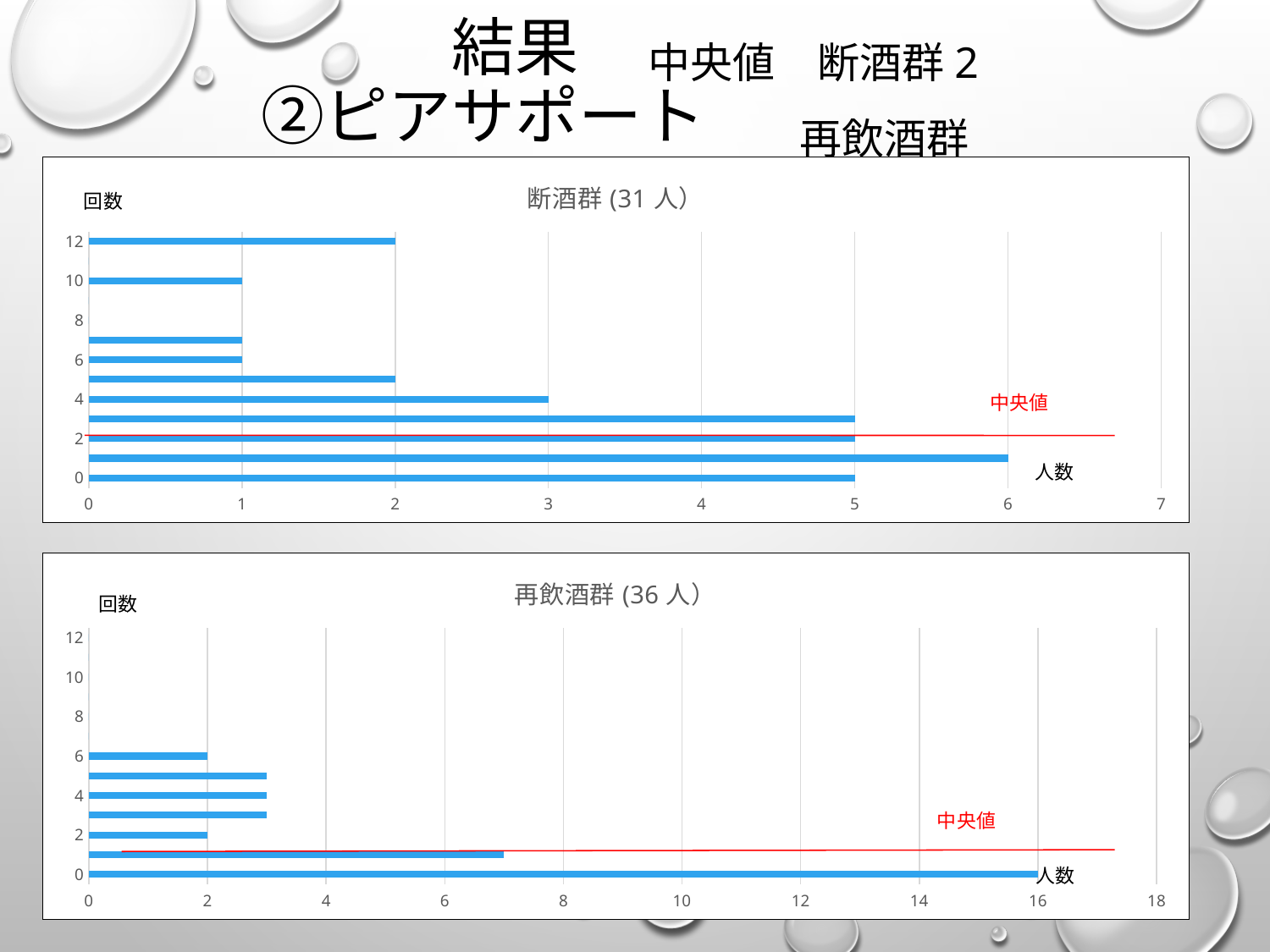
In the bottom chart (再飲酒群), which 回数 category has the highest 人数? 0 In the top chart (断酒群), which has the larger 人数: 回数 4 or 回数 5? 回数 4 In the top chart (断酒群), which 回数 category has the highest 人数? 1 In the top chart (断酒群), what is the difference in 人数 between 回数 0 and 回数 4? 2 How many bars are plotted in the bottom chart (再飲酒群)? 7 What kind of chart is the top chart titled 断酒群 (31 人)? bar chart What does the red horizontal line in each chart represent, according to its label? 中央値 In the bottom chart (再飲酒群), is the 人数 value for 回数 1 greater or less than 6? greater In the bottom chart (再飲酒群), what is the 人数 value for 回数 0? 16 In the top chart (断酒群), what is the 人数 value for 回数 4? 3 In the top chart (断酒群), what is the 人数 value for 回数 1? 6 In the bottom chart (再飲酒群), is the 人数 value for 回数 3 greater or less than 4? less